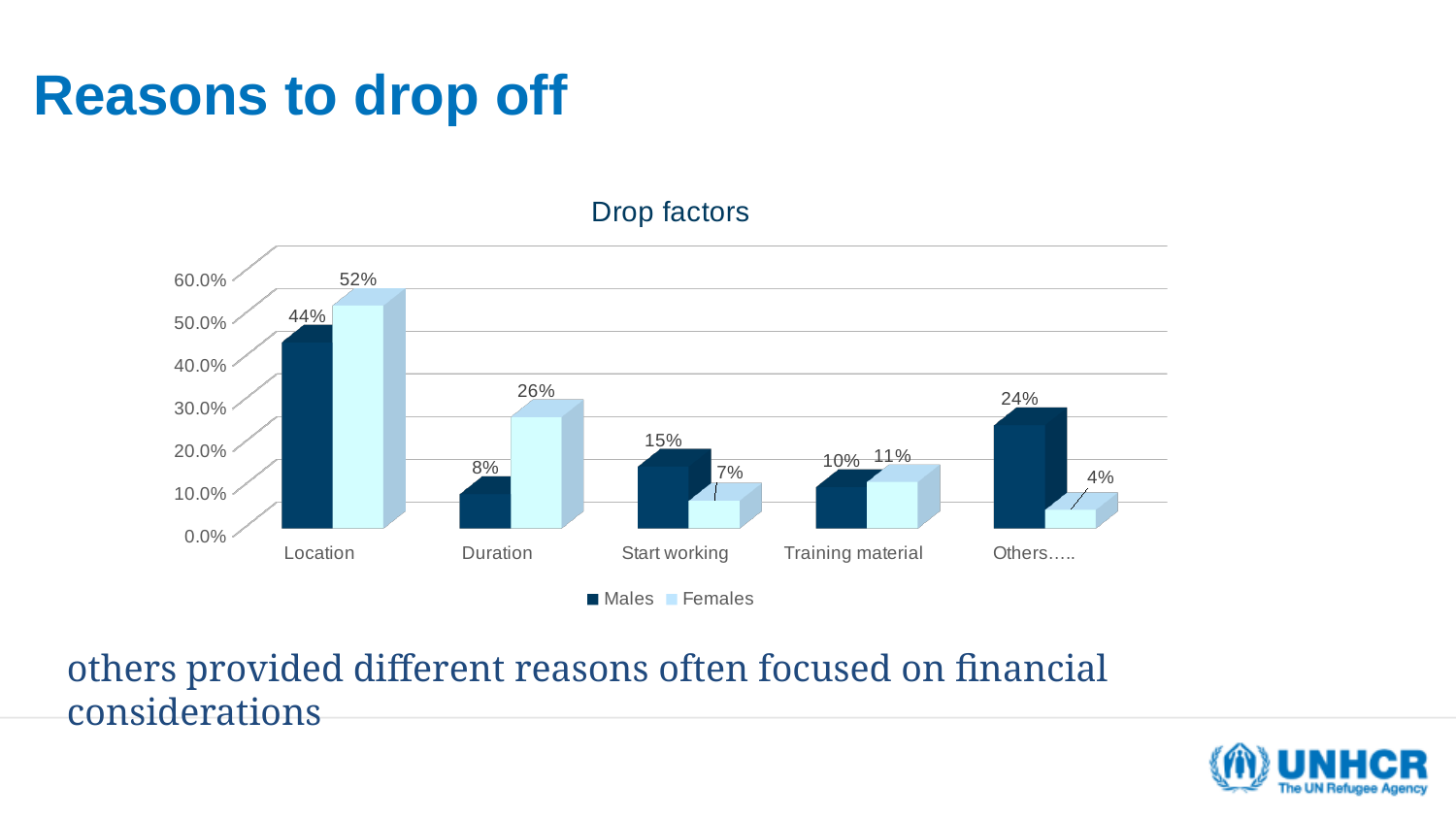
What is the value for Males in the Location category? 44% Which is larger for Start working, the Males value or the Females value? Males What is the value for Females in the Duration category? 26% Is the value for Males in the Others….. category greater or less than 20.0%? greater How many series does the legend list? 2 What is the title of the chart? Drop factors What kind of chart is shown? bar chart Which category has the lowest value for Males? Duration What is the value for Females in the Others….. category? 4% How many categories are shown on the x axis? 5 Which category has the highest value for Females? Location What is the difference between the Females and Males values for Location? 8%